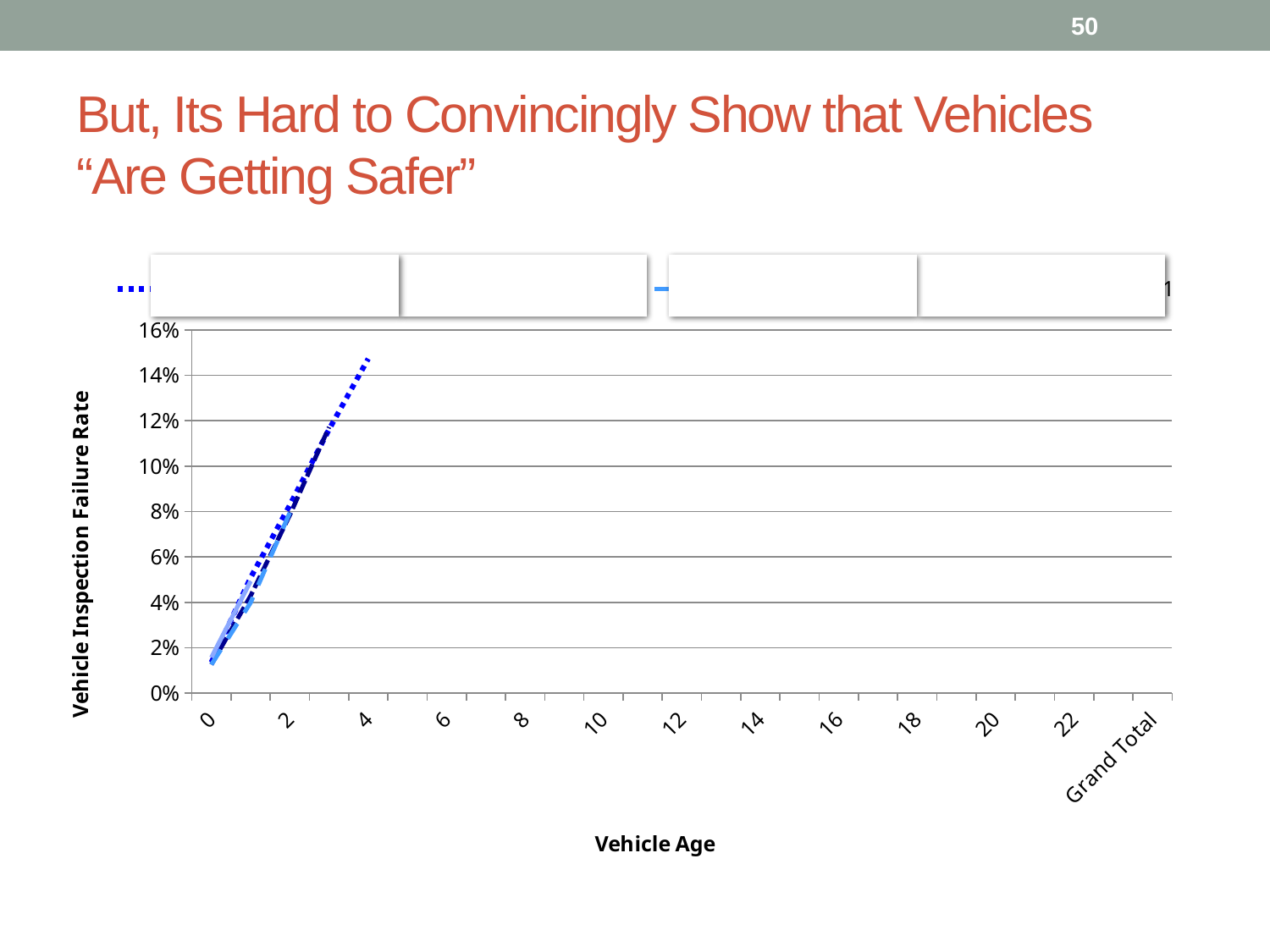
What is the last category label on the horizontal axis of the chart? Grand Total What is the title of the vertical axis of the chart? Vehicle Inspection Failure Rate What is the title of the horizontal axis of the chart? Vehicle Age Do the plotted lines rise or fall as vehicle age increases from 0 to 4? rise Is the highest plotted value on the chart greater or less than 16%? less What is the highest value shown on the vertical axis of the chart? 16% What kind of chart is shown on the slide? line chart Is the value of the dotted line at vehicle age 4 greater or less than 12%? greater How many tick labels are shown on the horizontal axis of the chart, including Grand Total? 13 Are the plotted values at vehicle age 0 greater or less than 2%? less